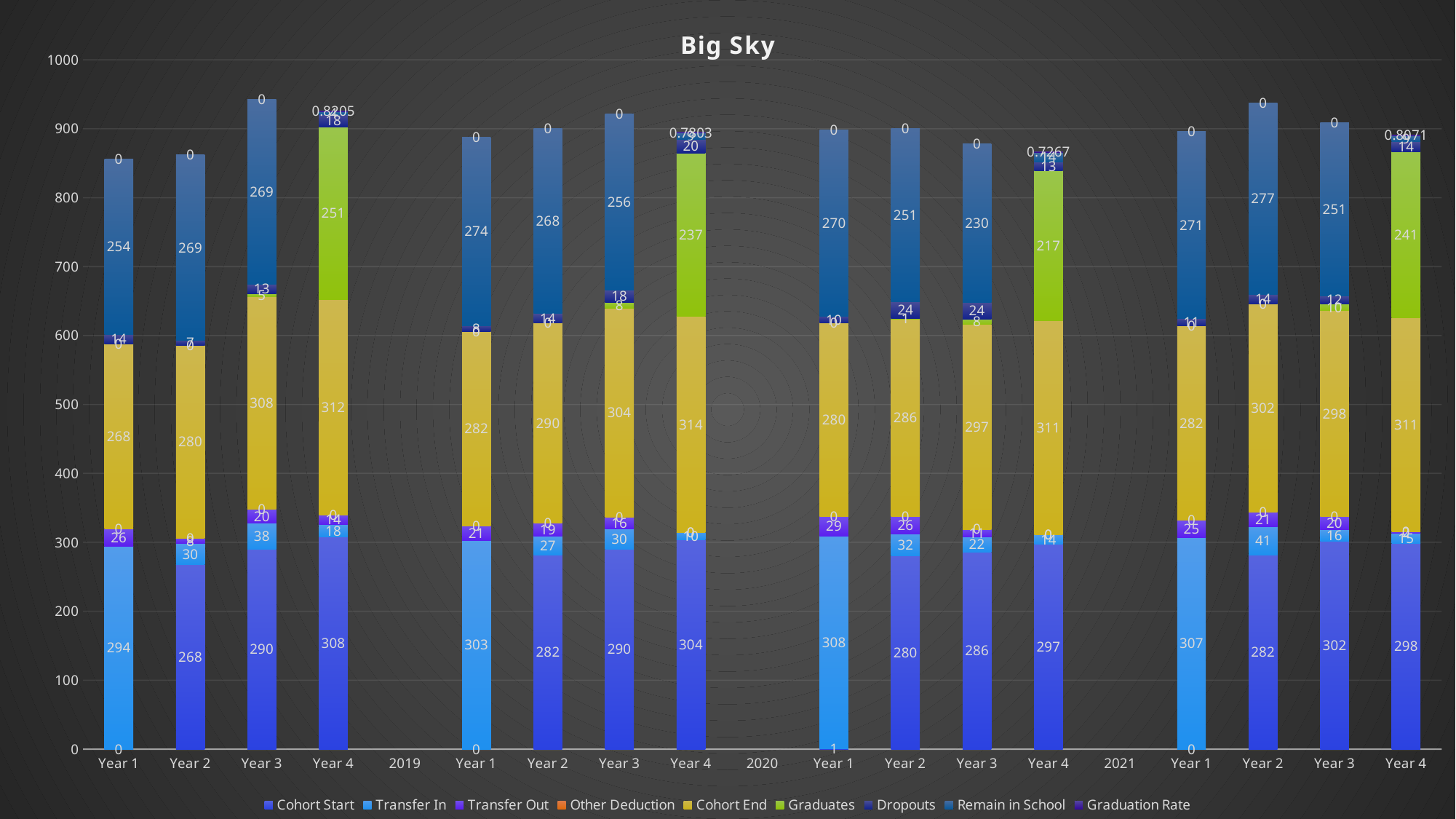
What is the title of the chart? Big Sky What graduation rate label is shown above the Year 4 bar immediately left of the 2020 label? 0.7803 What is the Graduates value for the Year 4 bar immediately left of the 2021 label? 217 What is the difference between the highest Graduates value (251) and the lowest Graduates value (217)? 34 Which has the larger Remain in School value: the Year 1 bar left of the 2019 label (254) or the Year 1 bar left of the 2020 label (274)? The Year 1 bar left of the 2020 label Is the total height of the Year 3 bar immediately left of the 2019 label greater or less than 900? greater Which Year 4 bar has the highest Graduates value? The Year 4 bar left of the 2019 label (251) What is the Graduates value for the Year 4 bar immediately left of the 2019 label? 251 What is the Cohort End value for the Year 4 bar immediately left of the 2020 label? 314 How many series does the legend list? 9 Which Year 4 bar has the lowest Graduates value? The Year 4 bar left of the 2021 label (217) What type of chart is shown on the slide? Stacked bar chart